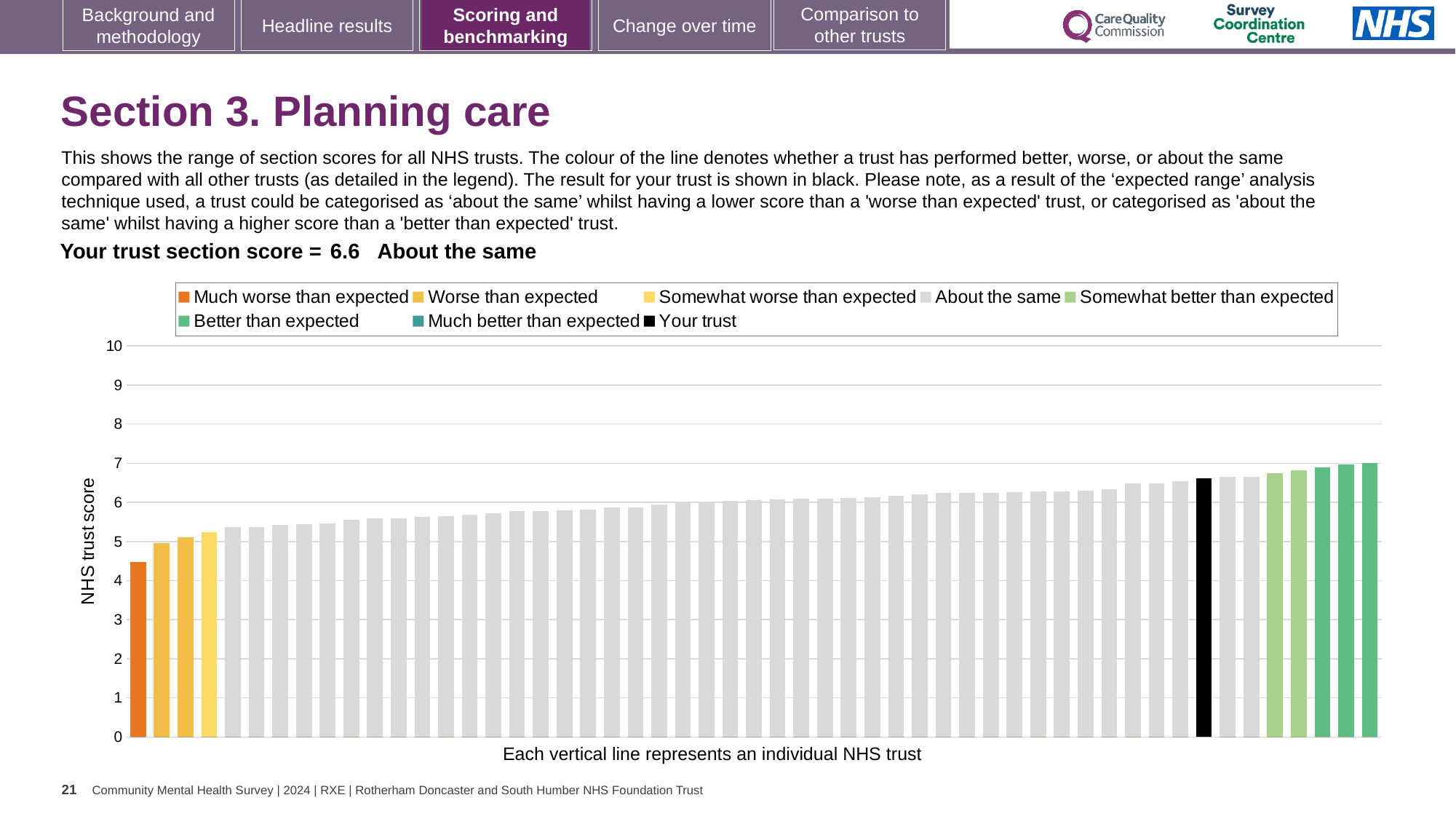
How many bars are coloured orange (much worse than expected)? 1 What kind of chart is shown on the slide? bar chart What is the section score for your trust shown on the slide? 6.6 Is the value of the black bar (your trust) greater or less than 6? greater Is the value of the rightmost bar greater or less than 6? greater Which benchmarking category is your trust placed in for Section 3. Planning care? About the same Is the value of the leftmost (orange) bar greater or less than 5? less Do the bar values rise or fall from left to right along the x axis? rise What colour is used for the bar representing your trust? black Which is larger, the orange bar on the far left or the black bar for your trust? the black bar How many entries does the chart legend list? 8 What is the label on the vertical axis of the chart? NHS trust score